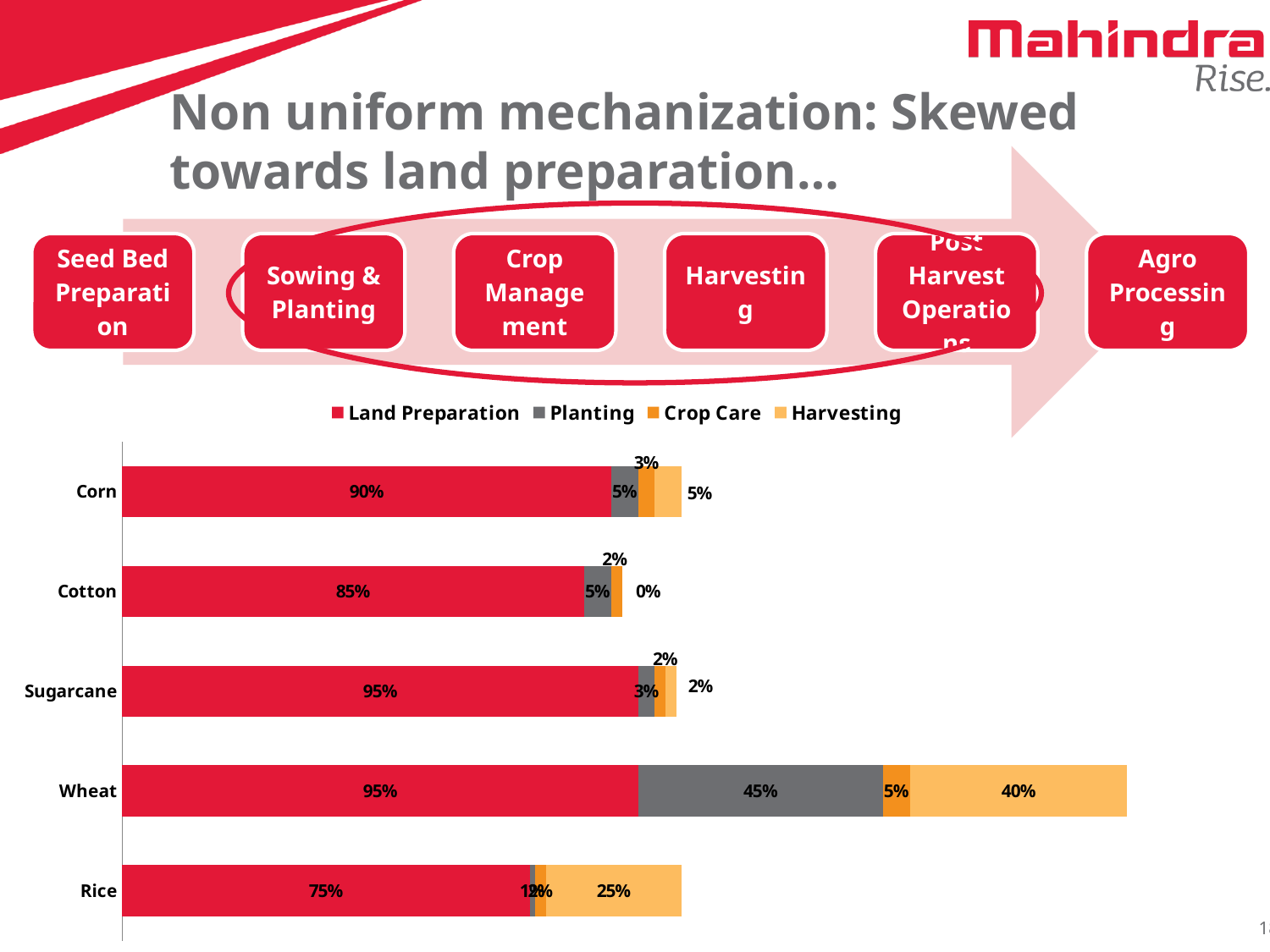
What is the Harvesting value for Rice? 25% How many crop categories are plotted in the chart? 5 What is the Crop Care value for Sugarcane? 2% What is the Harvesting value for Cotton? 0% What type of chart is shown on the slide? bar chart Which is larger, the Planting value for Wheat or the Planting value for Corn? Wheat Which crop has the lowest Land Preparation value? Rice What is the Land Preparation value for Corn? 90% How many series does the legend list? 4 What is the Planting value for Wheat? 45% What is the difference between the Land Preparation values for Sugarcane and Cotton? 10% Which crop has the highest Harvesting value? Wheat